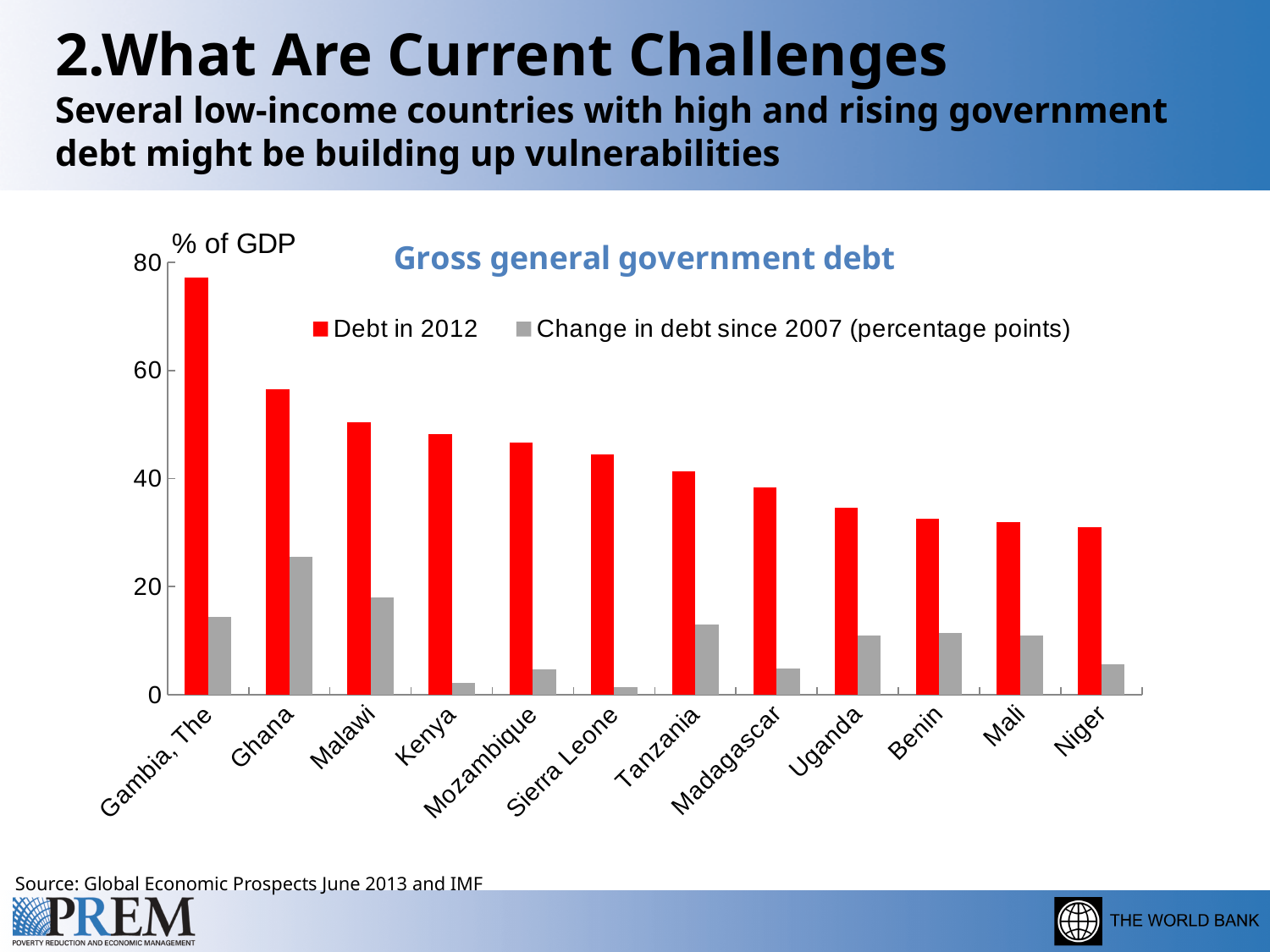
How many countries are shown on the x axis of the chart? 12 Is the Debt in 2012 value for Ghana greater or less than 60? less Which country has the lowest Debt in 2012? Niger Is the Debt in 2012 value for Gambia, The greater or less than 60? greater What is the title of the chart? Gross general government debt What kind of chart is shown on the slide? bar chart Which country has the highest Debt in 2012? Gambia, The Is the Change in debt since 2007 value for Ghana greater or less than 20? greater Do the Debt in 2012 values rise or fall moving from left to right along the x axis? fall How many series does the chart's legend list? 2 Which is larger, the Debt in 2012 for Ghana or for Malawi? Ghana Which country has the largest Change in debt since 2007? Ghana